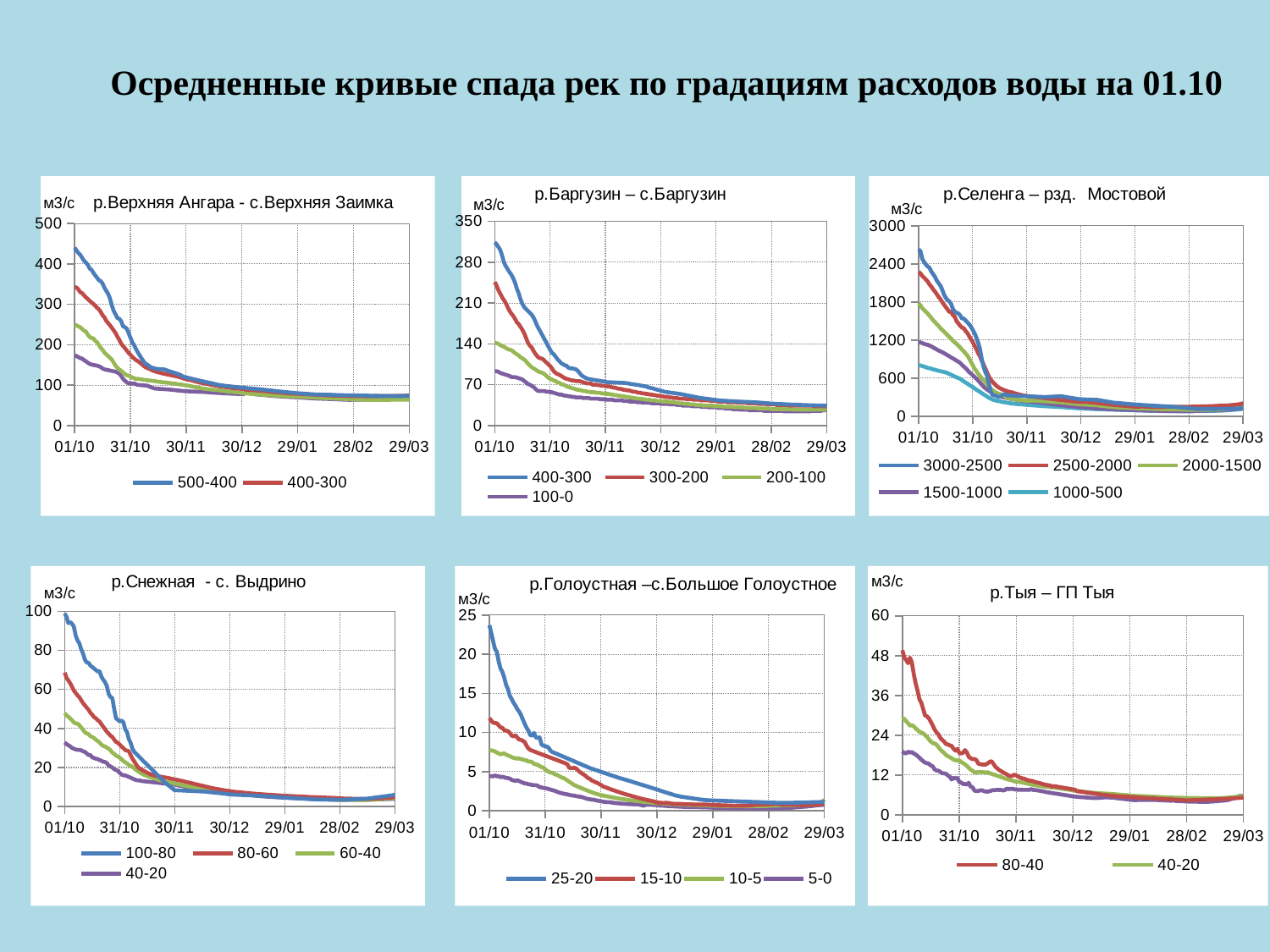
In the р.Тыя – ГП Тыя chart, is the value of the 80-40 series at 01/10 greater or less than 36? greater In the р.Баргузин – с.Баргузин chart, which series has the larger value at 01/10: 400-300 or 100-0? 400-300 In the р.Селенга – рзд. Мостовой chart, is the value of the 3000-2500 series at 01/10 greater or less than 2400? greater What is the title of the chart in the top-right position of the slide? р.Селенга – рзд. Мостовой In the р.Снежная - с. Выдрино chart, do the values rise or fall from 01/10 to 29/03? fall What unit is shown on the y axis of the р.Снежная - с. Выдрино chart? м3/с How many series does the legend list in the р.Тыя – ГП Тыя chart? 2 In the р.Голоустная – с.Большое Голоустное chart, is the value of the 25-20 series at 01/10 greater or less than 20? greater How many series does the legend list in the р.Голоустная – с.Большое Голоустное chart? 4 How many series does the legend list in the р.Селенга – рзд. Мостовой chart? 5 What kind of chart is the р.Баргузин – с.Баргузин chart? line chart